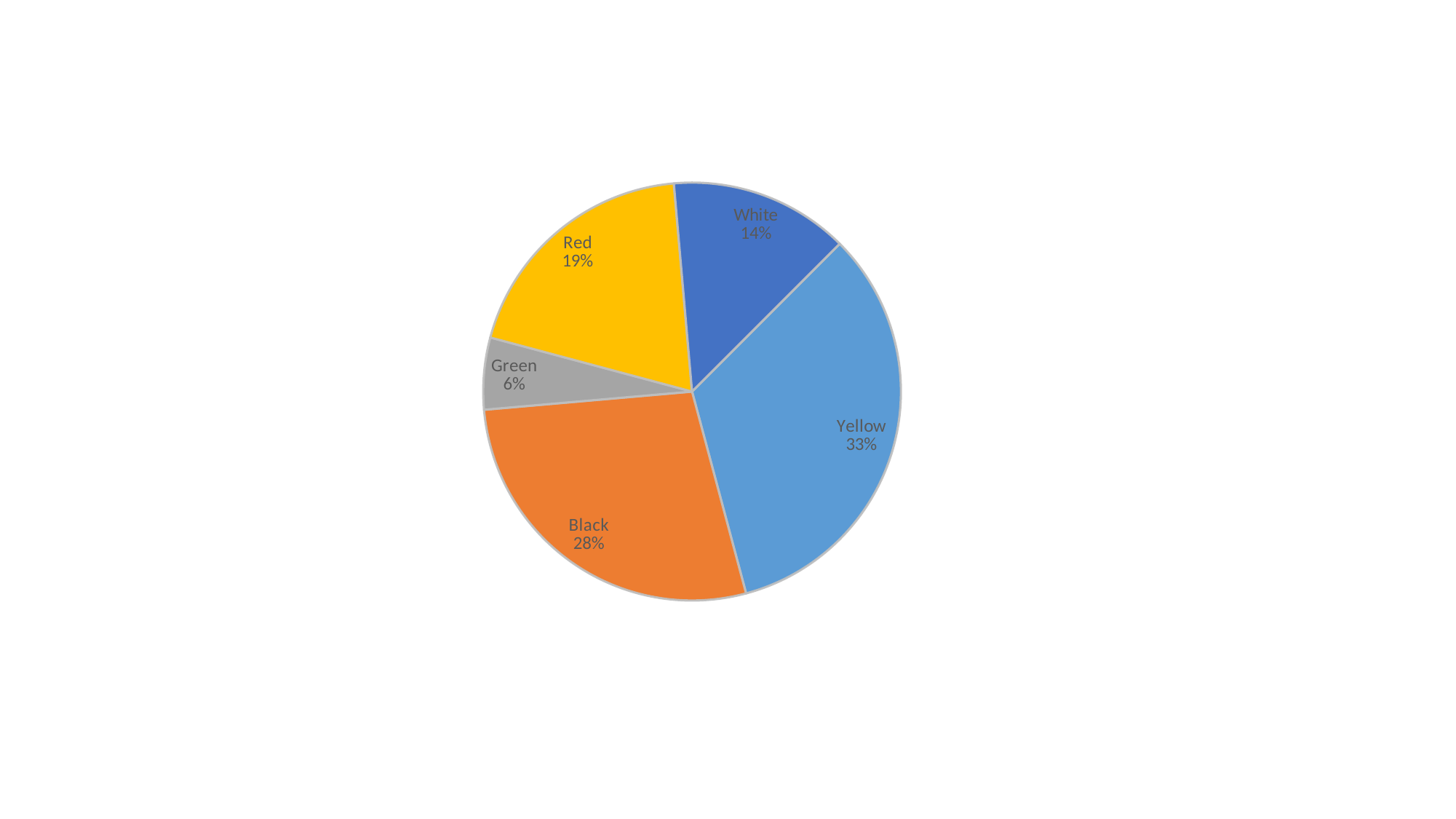
What share of the pie does the Green slice represent? 6% Which slice is the smallest? Green Which slice is larger, Red or White? Red What colour is the Black slice drawn in? orange What share of the pie does the Red slice represent? 19% What is the difference in percentage points between the Yellow and Black slices? 5 Which slice is the largest? Yellow What kind of chart is shown on the slide? pie chart What share of the pie does the White slice represent? 14% How many slices does the pie chart have? 5